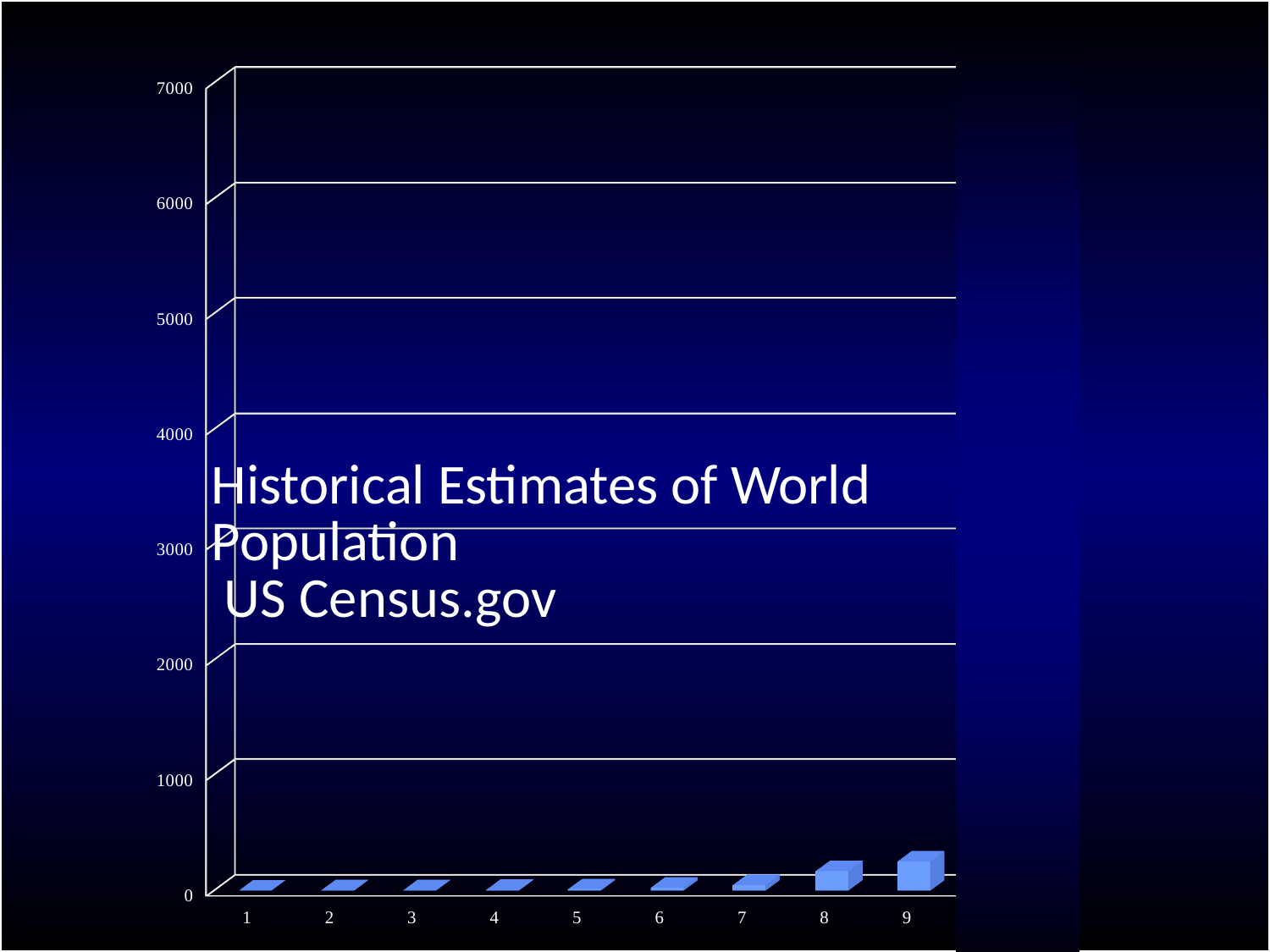
Which is larger, the value for category 8 or the value for category 1? 8 How many categories are shown on the x axis of the chart? 9 Do the values generally rise or fall from category 1 to category 9? rise What is the highest tick value shown on the y axis of the chart? 7000 What is the title text shown over the chart? Historical Estimates of World Population US Census.gov Is the value for category 9 greater or less than 1000? less Which is larger, the value for category 9 or the value for category 8? 9 Is the value for category 8 greater or less than 1000? less Is the value for category 1 greater or less than 1000? less What kind of chart is shown on the slide? bar chart